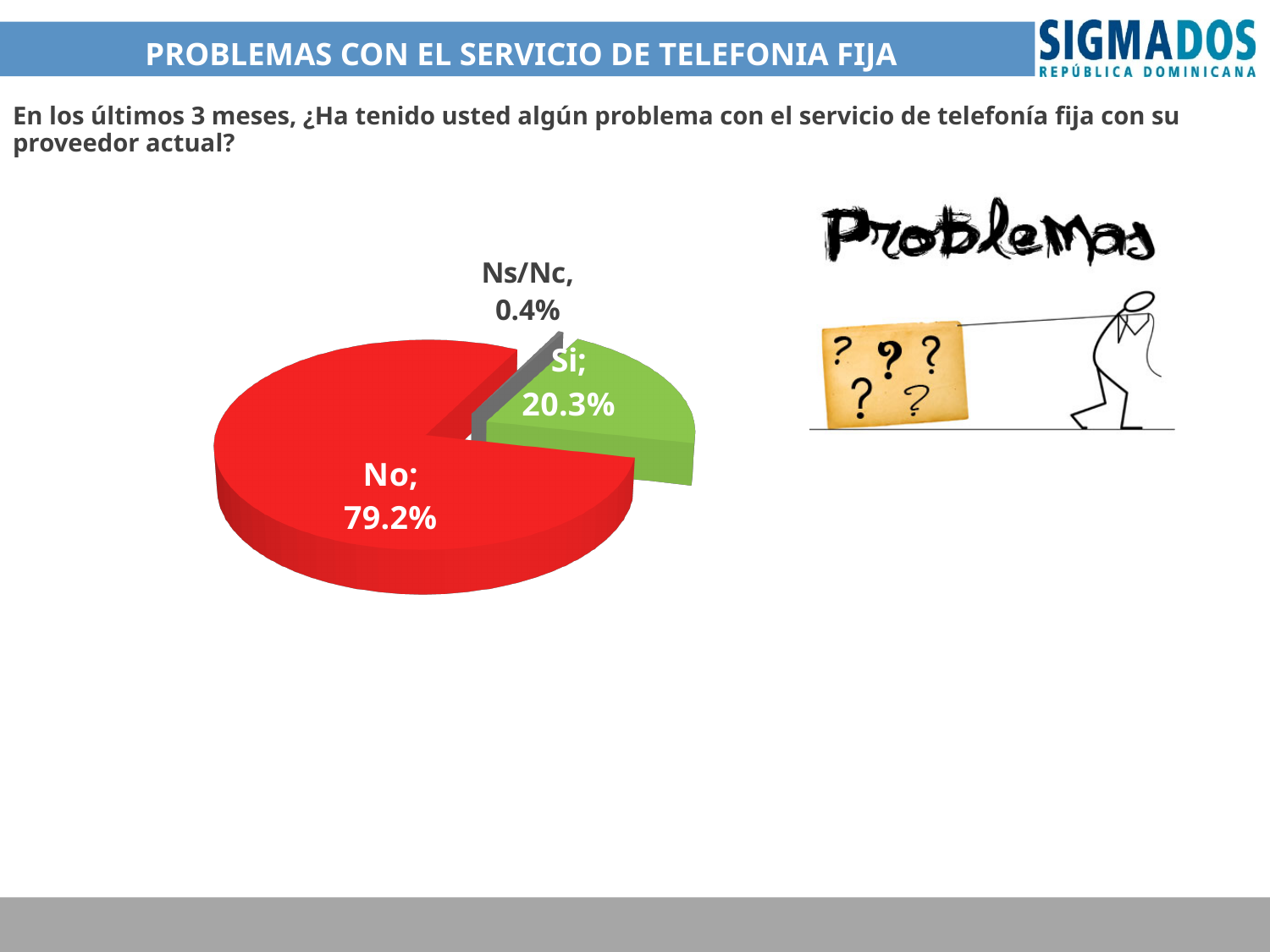
What percentage of respondents answered "Si"? 20.3% Which response has the smallest share of the pie? Ns/Nc Which response has the largest share of the pie? No What percentage is shown for "Ns/Nc"? 0.4% What colour is the "Si" slice of the pie? green What colour is the "No" slice of the pie? red How many slices does the pie chart have? 3 What percentage of respondents answered "No"? 79.2% What is the difference in percentage points between "No" and "Si"? 58.9 Which is larger, the share for "Si" or the share for "Ns/Nc"? Si What kind of chart is shown on the slide? pie chart